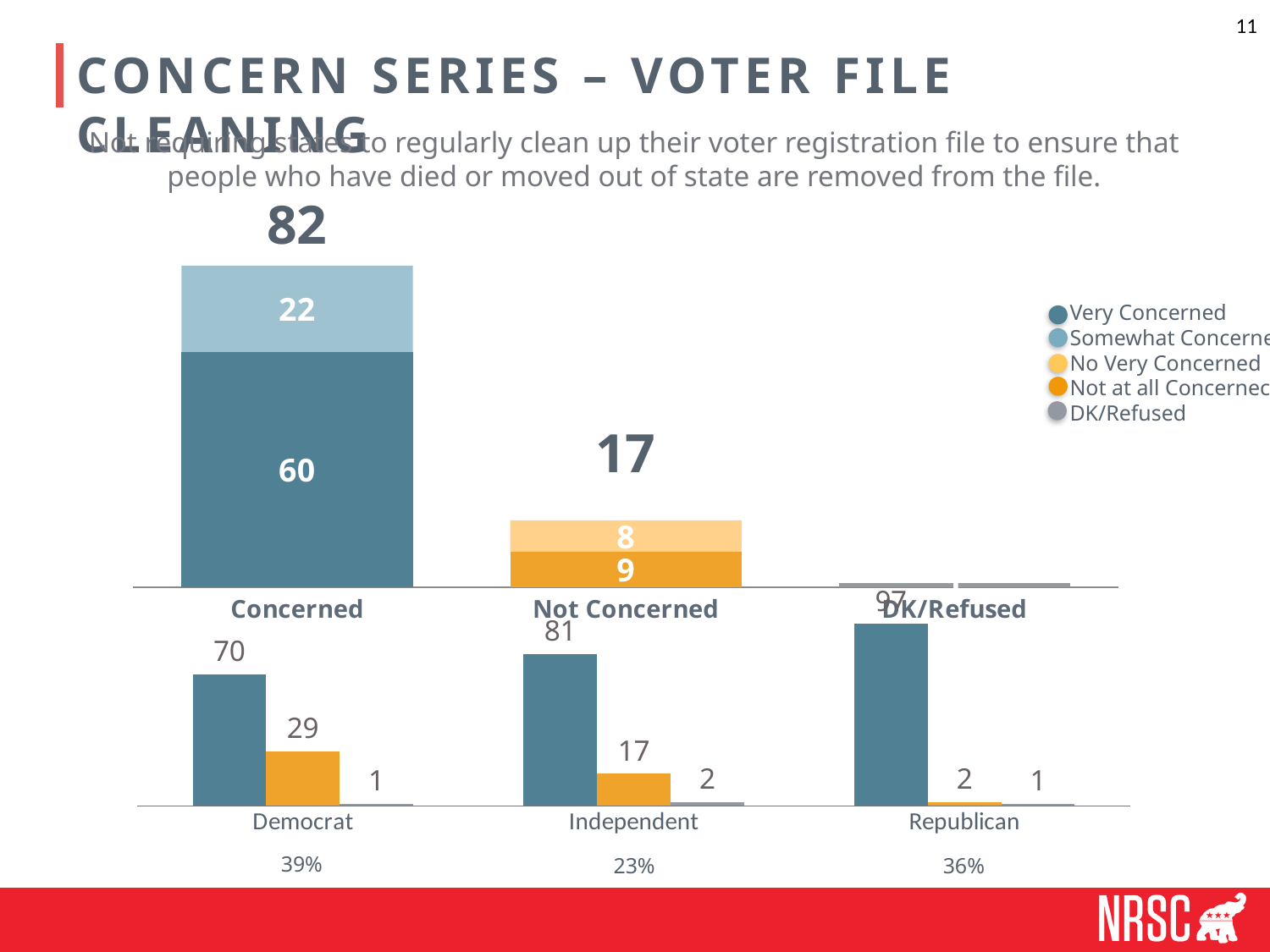
In the bottom chart, which party group has the highest value for its tallest bar? Republican In the bottom chart, what is the difference between the Democrat second bar (29) and the Independent second bar (17)? 12 How many entries does the legend of the top chart list? 5 In the bottom chart, what is the value of the tallest bar for Independent? 81 In the bottom chart, what is the value of the tallest bar for Democrat? 70 In the bottom chart, what is the value of the tallest bar for Republican? 97 In the top stacked bar chart, what is the total for the Not Concerned bar? 17 In the top stacked bar chart, what is the Somewhat Concerned value within the Concerned bar? 22 In the top stacked bar chart, what is the difference between the Concerned total and the Not Concerned total? 65 In the top stacked bar chart, what is the total for the Concerned bar? 82 In the top stacked bar chart, what is the Very Concerned value within the Concerned bar? 60 What kind of chart is the top chart on the slide? Stacked bar chart